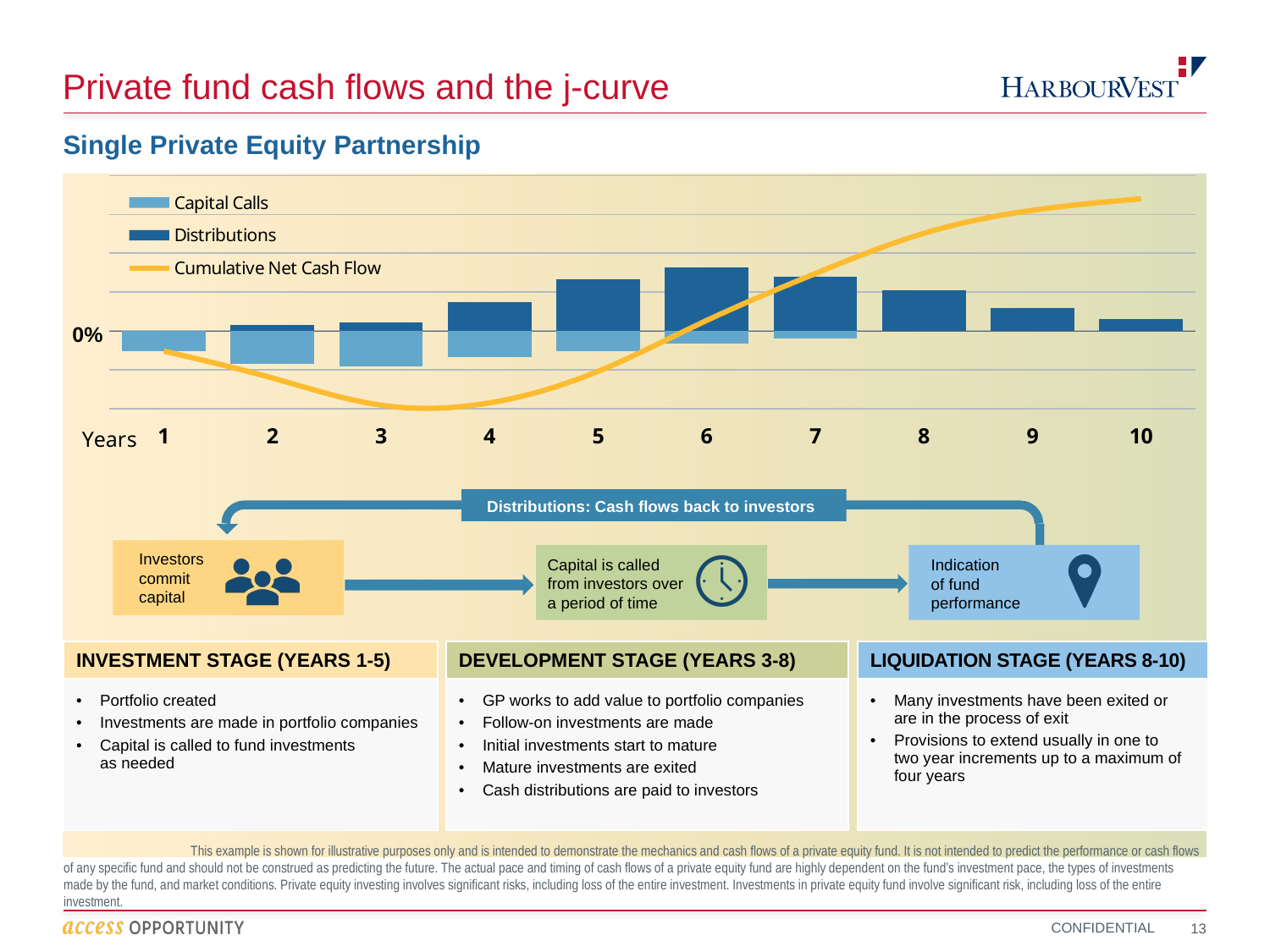
Are Capital Calls larger in year 3 or in year 7? year 3 In which year are Distributions highest? 6 Does the Cumulative Net Cash Flow line rise or fall from year 4 to year 10? rise Are Distributions larger in year 6 or in year 9? year 6 Is the Cumulative Net Cash Flow in year 2 greater or less than 0%? less Which series is plotted as a line rather than bars? Cumulative Net Cash Flow Is the Cumulative Net Cash Flow in year 8 greater or less than 0%? greater How many series does the legend list? 3 What is the label on the x axis of the chart? Years Does the Cumulative Net Cash Flow line rise or fall from year 1 to year 3? fall How many years are shown along the x axis? 10 What kind of chart is shown on the slide? combination bar and line chart